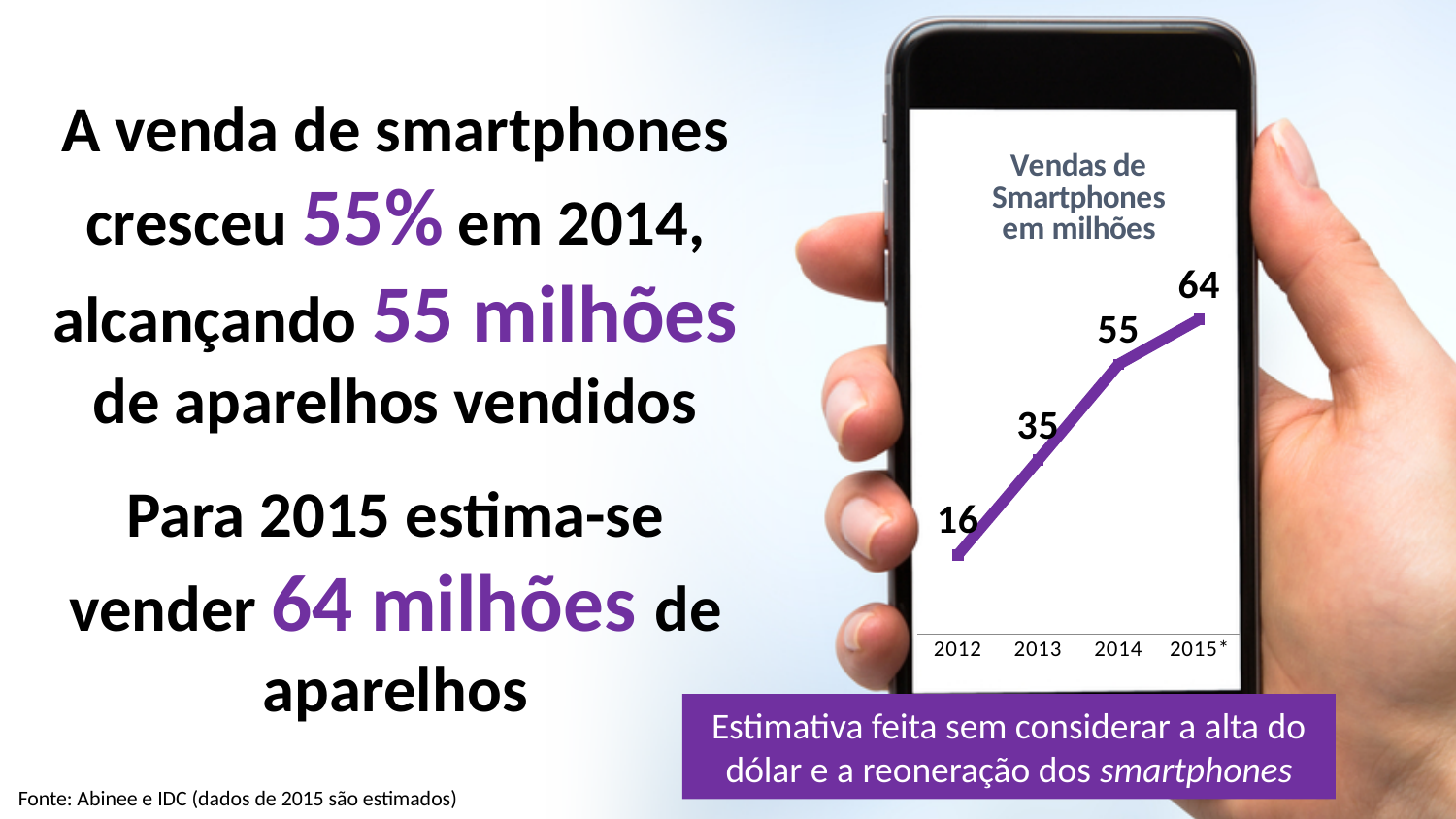
What is the value for 2014 in the chart? 55 What is the value for 2012 in the chart? 16 What is the value for 2013 in the chart? 35 What kind of chart is shown on the slide? line chart What is the difference between the values for 2015* and 2012? 48 What is the value for 2015* in the chart? 64 Which is larger, the value for 2013 or the value for 2014? 2014 How many data points are plotted in the chart? 4 Which year has the highest value in the chart? 2015* Do the values rise or fall from 2012 to 2015*? rise What is the difference between the values for 2014 and 2013? 20 Which year has the lowest value in the chart? 2012